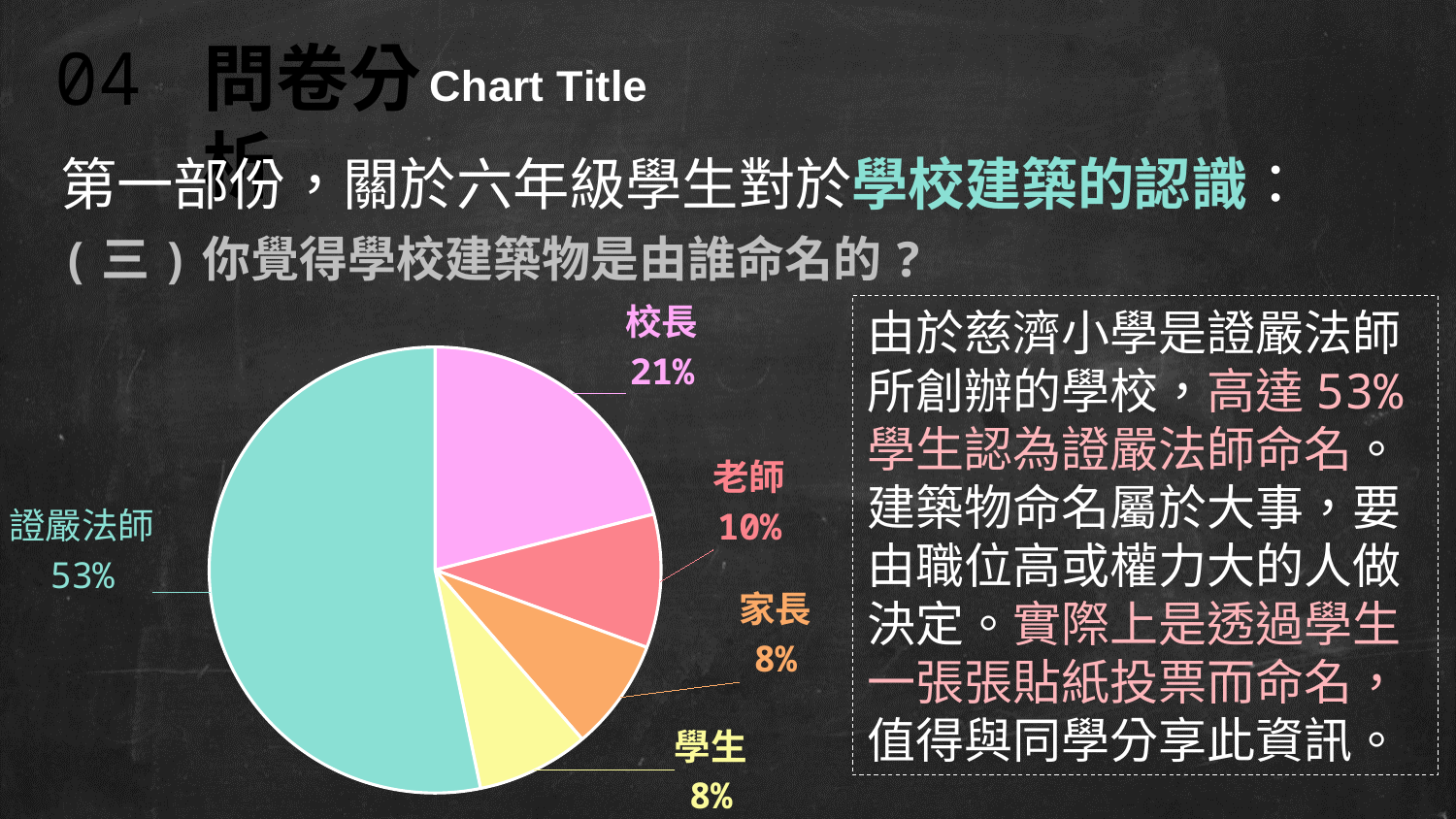
What percentage of the pie is labelled 老師? 10% What percentage of the pie is labelled 家長? 8% What is the difference in percentage points between 證嚴法師 and 校長? 32 Which slice is larger, 校長 or 老師? 校長 What kind of chart is shown on the slide? pie chart What is the title shown above the pie chart? Chart Title How many slices does the pie chart have? 5 What percentage of the pie is labelled 校長? 21% What percentage of the pie is labelled 證嚴法師? 53% What is the difference in percentage points between 老師 and 學生? 2 What colour is the 證嚴法師 slice of the pie? teal Which category has the largest slice of the pie? 證嚴法師